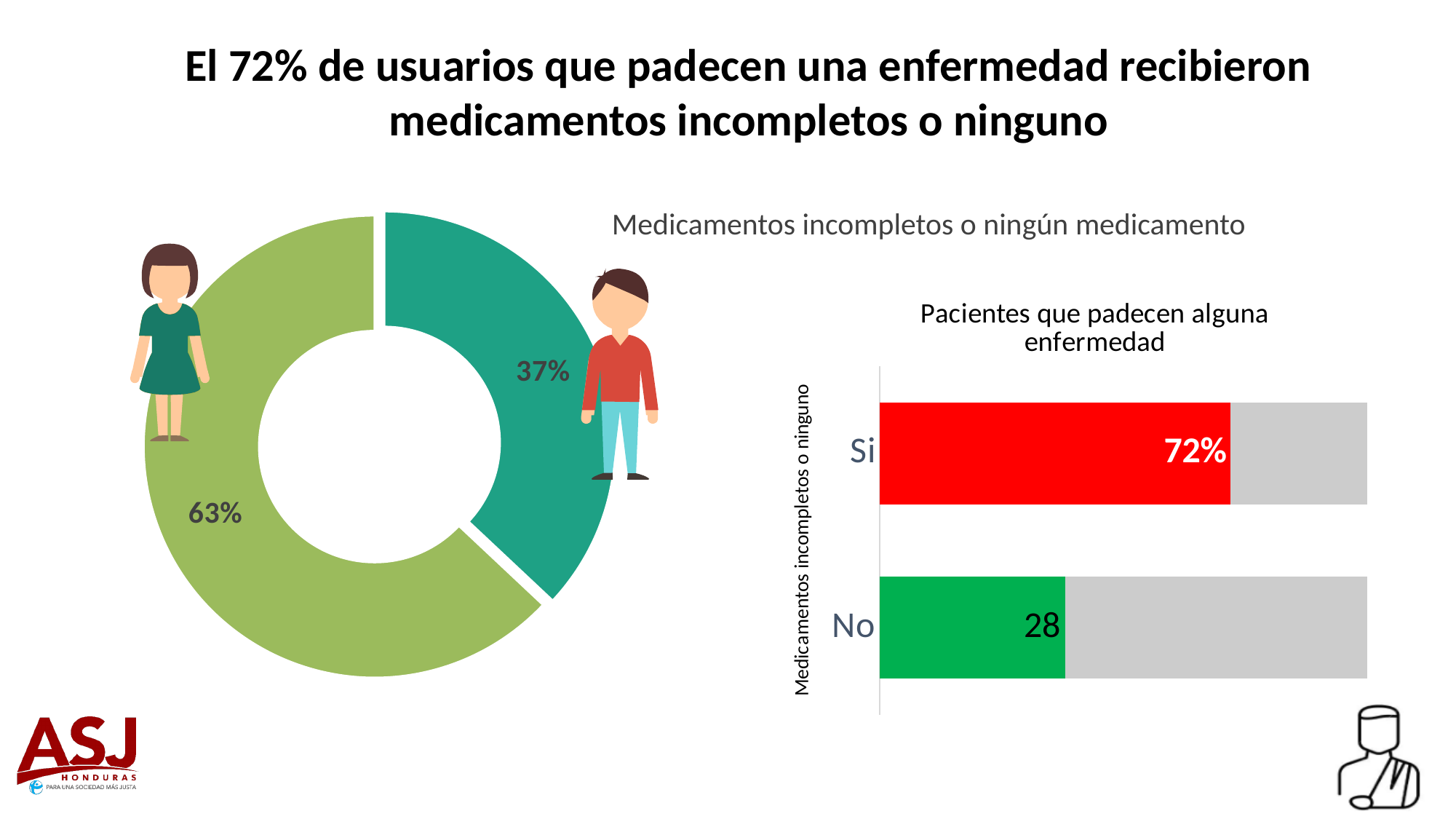
In the bar chart titled 'Pacientes que padecen alguna enfermedad', what is the value for 'No'? 28 In the bar chart titled 'Pacientes que padecen alguna enfermedad', what colour is the bar for 'Si'? Red In the donut chart on the left of the slide, what is the value of the larger slice? 63% In the bar chart titled 'Pacientes que padecen alguna enfermedad', what is the label on the vertical axis? Medicamentos incompletos o ninguno In the bar chart titled 'Pacientes que padecen alguna enfermedad', which category has the lower value? No In the bar chart titled 'Pacientes que padecen alguna enfermedad', how many categories are shown? 2 What kind of chart is the chart titled 'Pacientes que padecen alguna enfermedad'? Bar chart In the bar chart titled 'Pacientes que padecen alguna enfermedad', what is the value for 'Si'? 72% In the donut chart on the left of the slide, what is the difference between the two slice values? 26% In the donut chart on the left of the slide, how many slices are there? 2 In the donut chart on the left of the slide, what is the value of the smaller slice? 37% In the bar chart titled 'Pacientes que padecen alguna enfermedad', which category has the higher value? Si